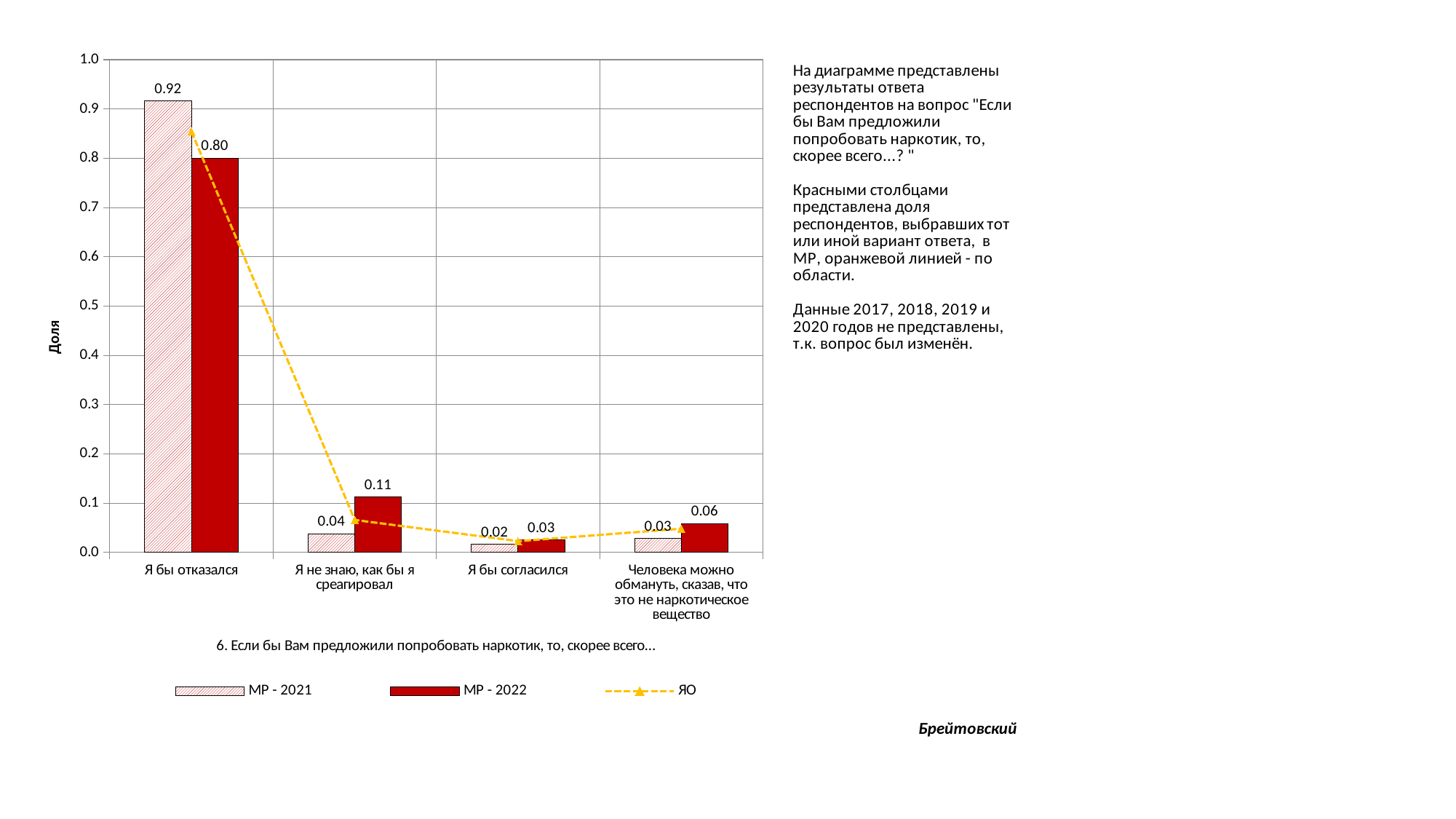
What is the value for МР - 2021 in the category "Я бы согласился"? 0.02 What is the difference between the МР - 2021 and МР - 2022 values in the category "Я бы отказался"? 0.12 What is the value for МР - 2022 in the category "Я не знаю, как бы я среагировал"? 0.11 How many series does the legend list? 3 What is the value for МР - 2022 in the category "Я бы отказался"? 0.80 In the category "Человека можно обмануть, сказав, что это не наркотическое вещество", which is larger: МР - 2021 or МР - 2022? МР - 2022 What is the label of the y axis? Доля How many categories are shown on the x axis? 4 Which category has the lowest value for МР - 2021? Я бы согласился Is the ЯО value for "Я бы отказался" greater or less than 0.8? greater Which category has the highest value for МР - 2022? Я бы отказался What is the value for МР - 2021 in the category "Я бы отказался"? 0.92